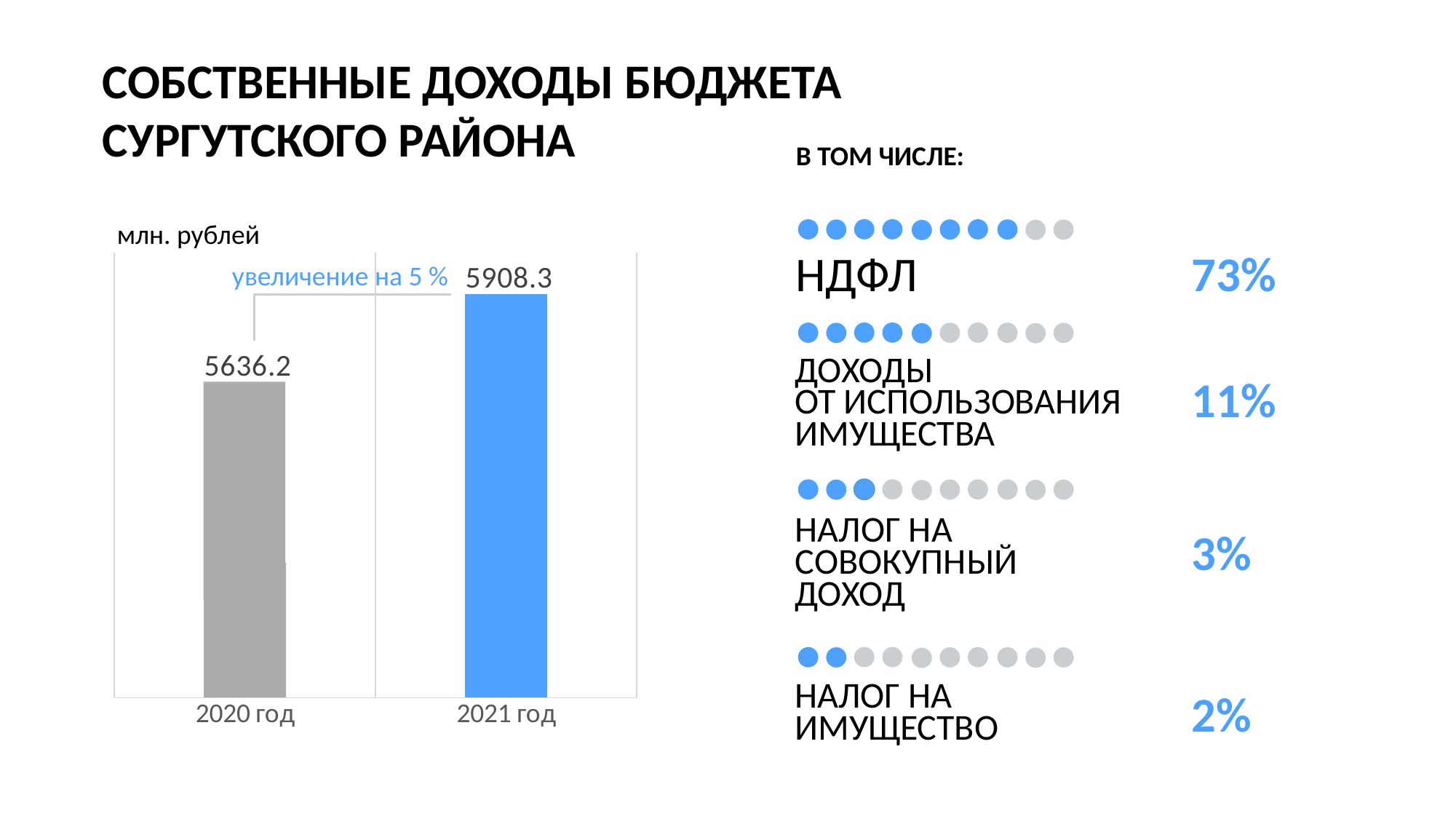
What is the difference between the 2021 год and 2020 год values in the bar chart? 272.1 Do the values in the bar chart rise or fall from 2020 год to 2021 год? rise In the breakdown on the right of the slide, what share is shown for НДФЛ? 73% Is the value for 2021 год larger or smaller than the value for 2020 год? larger How many bars are shown in the bar chart? 2 What is the value for 2021 год in the bar chart? 5908.3 What kind of chart is shown on the left of the slide? bar chart What is the value for 2020 год in the bar chart? 5636.2 Which year has the lower value in the bar chart? 2020 год What unit is indicated for the values in the bar chart? млн. рублей Which year has the higher value in the bar chart? 2021 год What percentage increase is annotated between the two bars in the bar chart? 5 %